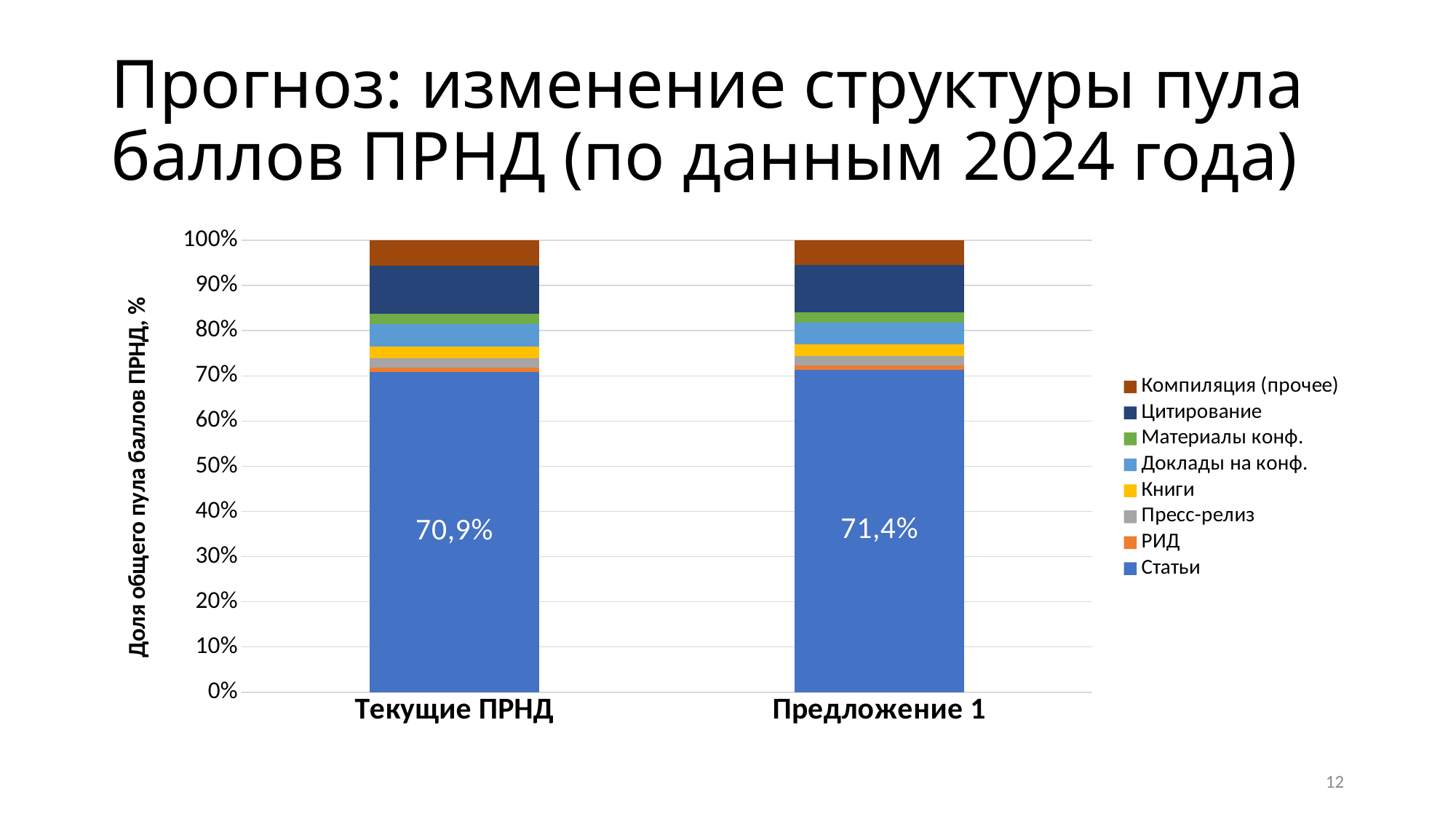
How many series does the legend list? 8 Which series takes the largest share in the Текущие ПРНД bar? Статьи By how many percentage points does the Статьи share in Предложение 1 exceed that in Текущие ПРНД? 0,5% Which series is listed first (at the top) in the legend? Компиляция (прочее) What is the title of the vertical axis? Доля общего пула баллов ПРНД, % What kind of chart is shown on the slide? Stacked bar chart Is the Статьи share in the Текущие ПРНД bar greater or less than 50%? greater What is the share of Статьи in the Текущие ПРНД bar? 70,9% What is the share of Статьи in the Предложение 1 bar? 71,4% How many bars (categories) are shown on the x axis? 2 Which bar has the larger share for Статьи, Текущие ПРНД or Предложение 1? Предложение 1 What is the total height of each stacked bar? 100%